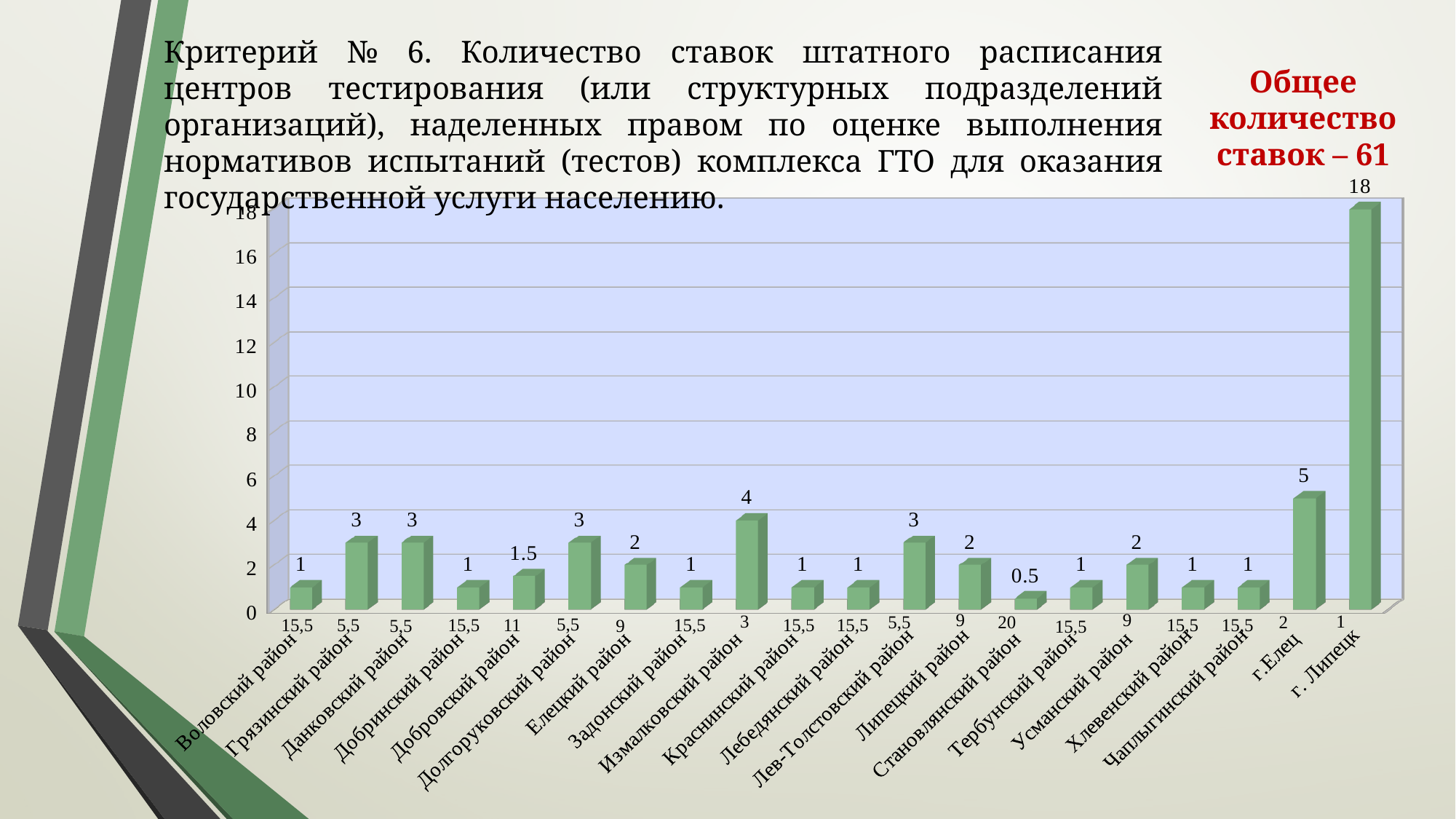
What is the value for г.Елец? 5 What kind of chart is shown on the slide? bar chart What is the value for г. Липецк? 18 What is the value for Измалковский район? 4 Is the value for г. Липецк greater or less than 16? greater What is the value for Добровский район? 1.5 What is the difference between the values for г. Липецк and г.Елец? 13 What is the value for Становлянский район? 0.5 Which is larger, the value for Измалковский район or the value for Липецкий район? Измалковский район Which category has the lowest value? Становлянский район How many categories are shown on the x axis? 20 Which category has the highest value? г. Липецк